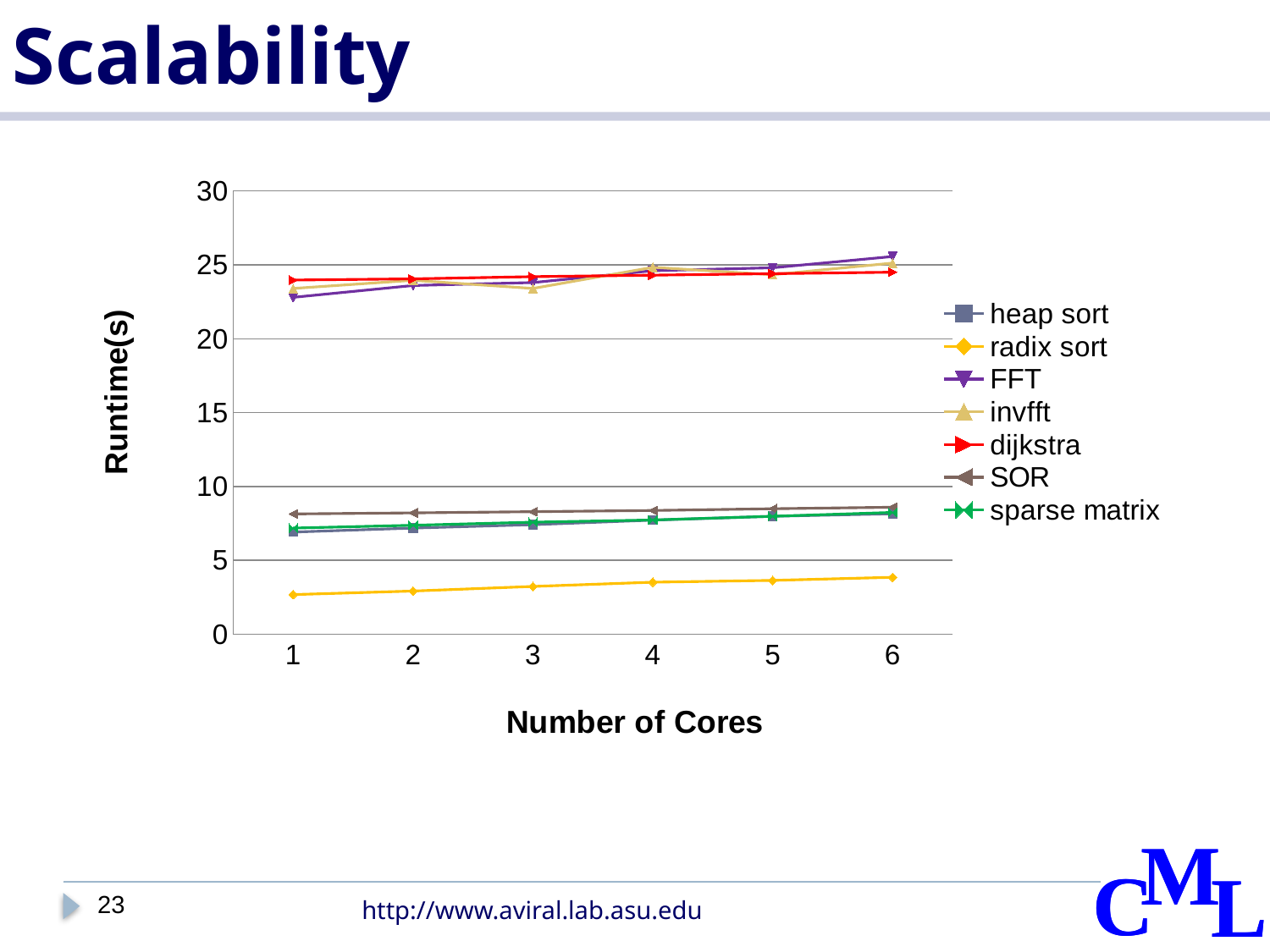
What is the title of the y axis? Runtime(s) Which series has the lowest runtime at 1 core? radix sort At 1 core, which has the larger runtime, dijkstra or radix sort? dijkstra What kind of chart is shown on the slide? line chart How many values of Number of Cores are plotted along the x axis? 6 Is the runtime for dijkstra at 1 core greater or less than 20? greater What is the title of the x axis? Number of Cores At 6 cores, which has the larger runtime, FFT or sparse matrix? FFT Does the runtime for radix sort rise or fall as the number of cores increases from 1 to 6? rises How many series does the legend list? 7 Is the runtime for radix sort at 1 core greater or less than 5? less Is the runtime for SOR at 6 cores greater or less than 10? less